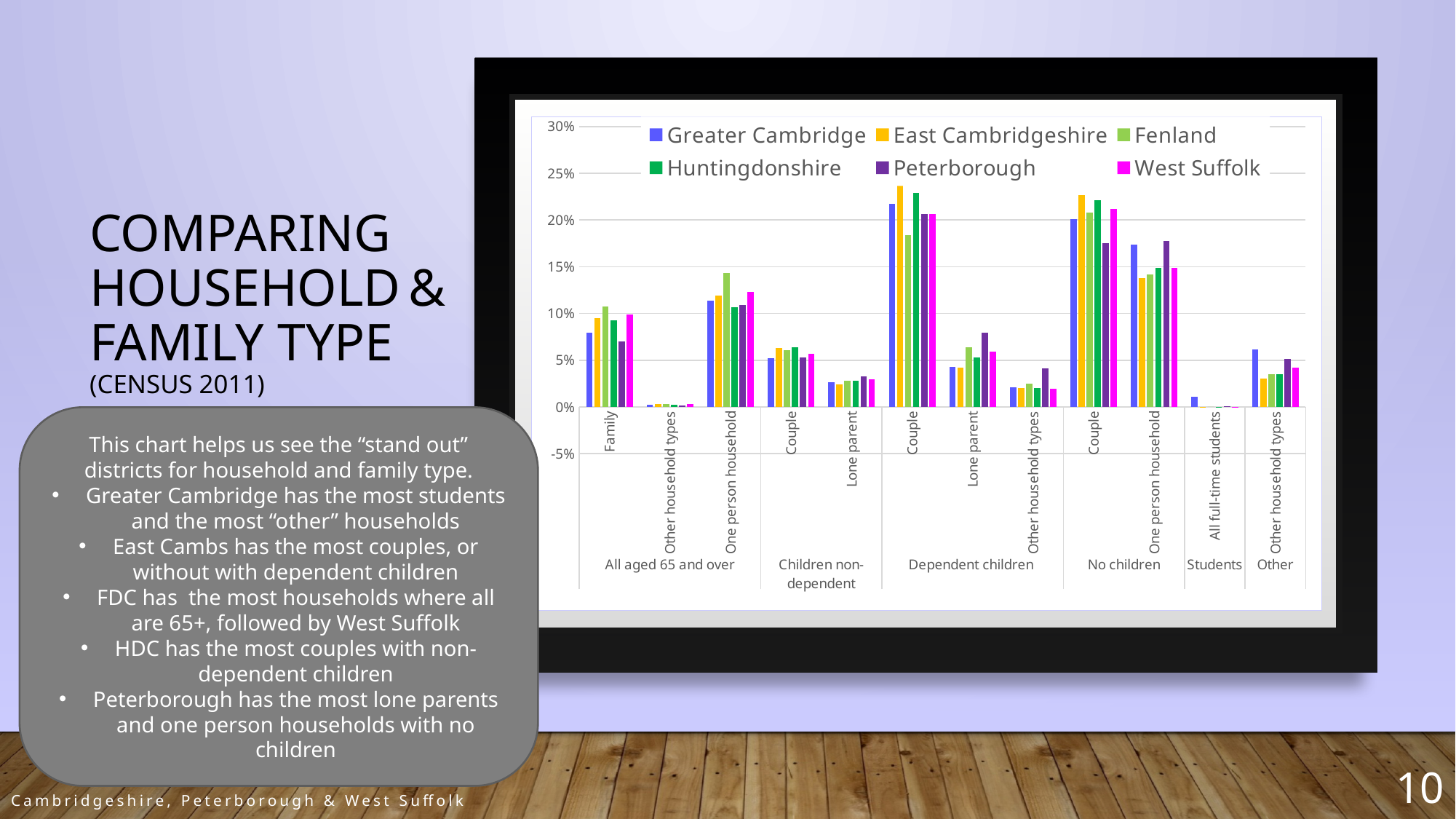
What kind of chart is shown on the slide? Bar chart Is the value for Fenland for Couple under Dependent children greater or less than 20%? less How many household/family type categories are plotted along the x axis? 12 Which district has the highest value for Lone parent under Dependent children? Peterborough Which district has the highest value for Family under All aged 65 and over? Fenland Which district has the lowest value for Family under All aged 65 and over? Peterborough Which is larger for Lone parent under Dependent children: Peterborough or Greater Cambridge? Peterborough Which district has the highest value for All full-time students? Greater Cambridge Is the value for Greater Cambridge for Couple under Dependent children greater or less than 20%? greater How many series does the legend list? 6 What colour represents West Suffolk in the legend? Magenta (pink)